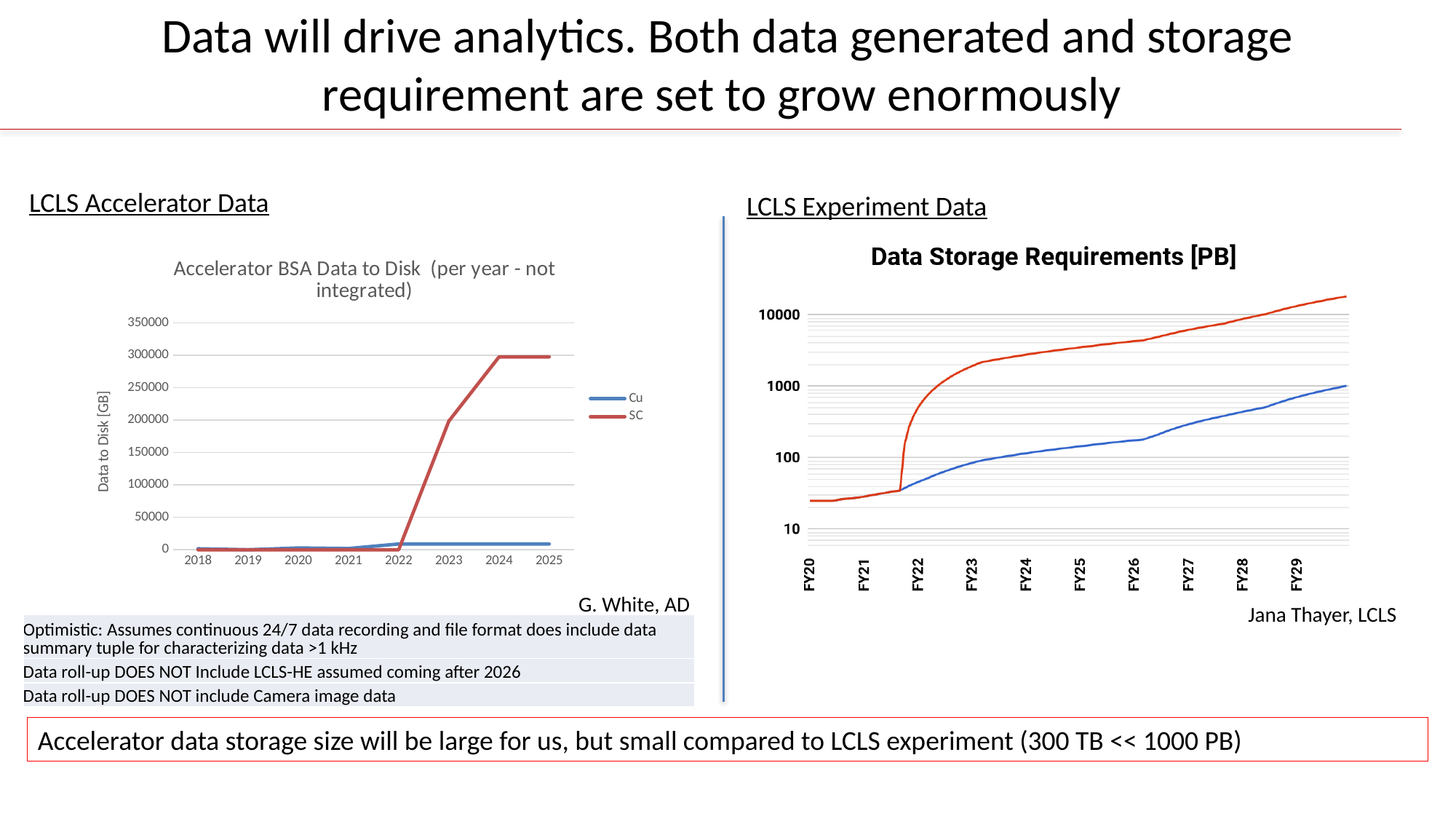
In the 'Accelerator BSA Data to Disk' chart, is the SC value for 2024 greater or less than 250000? greater What is the y-axis label of the 'Accelerator BSA Data to Disk' chart? Data to Disk [GB] How many years are shown on the x axis of the 'Accelerator BSA Data to Disk' chart? 8 In the 'Accelerator BSA Data to Disk' chart, does the SC series rise or fall between 2022 and 2024? rise What kind of chart is the 'Accelerator BSA Data to Disk' chart on the left? line chart In the 'Accelerator BSA Data to Disk' chart, which series has the larger value in 2024, Cu or SC? SC In the 'Accelerator BSA Data to Disk' chart, is the SC value for 2022 greater or less than 50000? less In the 'Data Storage Requirements [PB]' chart, is the blue line's value at FY28 greater or less than 1000? less In the 'Data Storage Requirements [PB]' chart, which line is higher at FY25, the red line or the blue line? red line How many series does the legend of the 'Accelerator BSA Data to Disk' chart list? 2 How many fiscal years are labelled on the x axis of the 'Data Storage Requirements [PB]' chart? 10